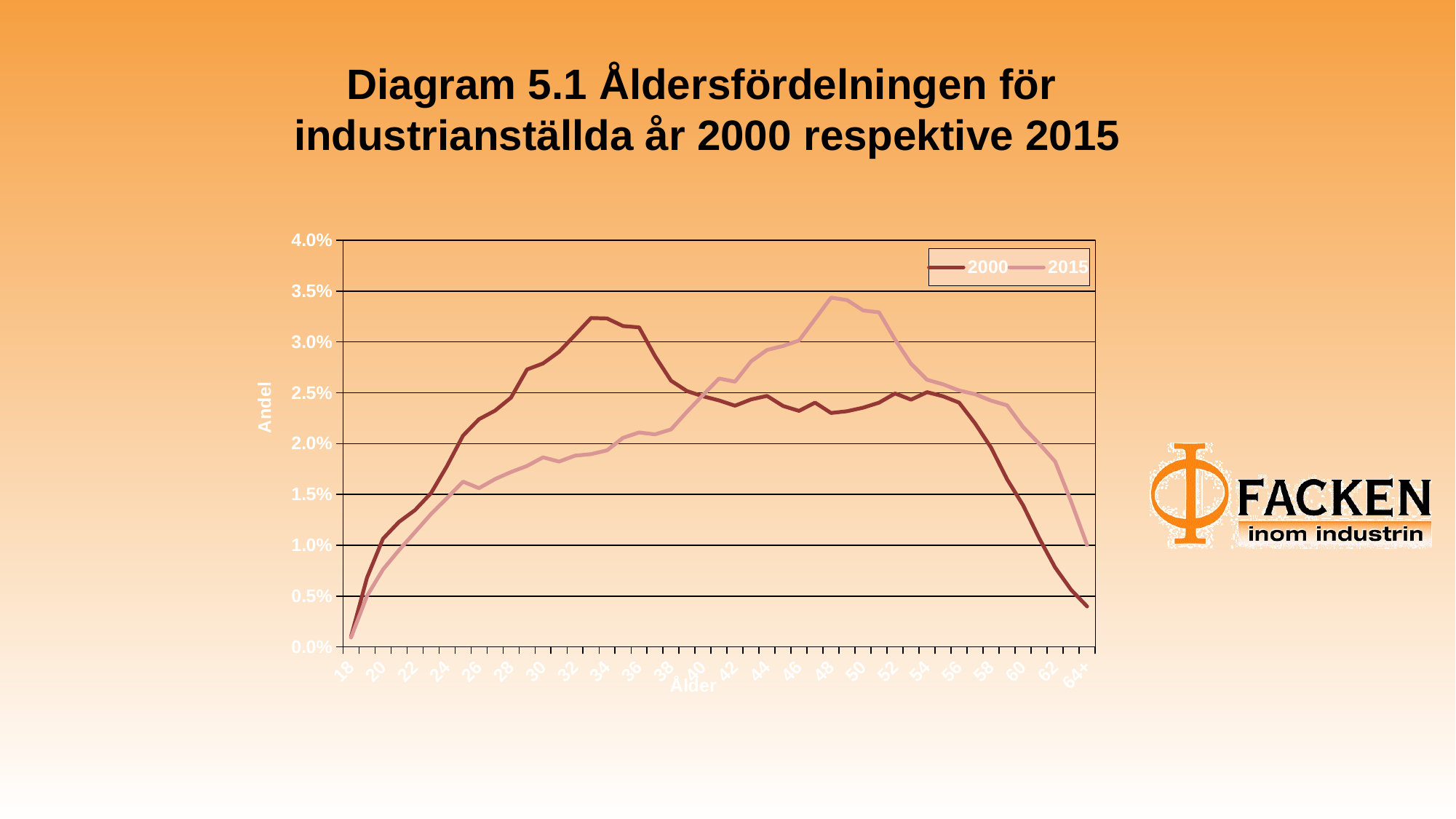
Is the value for the 2000 series at age 34 greater or less than 3.0%? greater Is the value for the 2015 series at age 48 greater or less than 3.0%? greater At age 48, which series has the higher value, 2000 or 2015? 2015 What is the label on the vertical axis? Andel Is the value for the 2015 series at age 34 greater or less than 2.0%? less Which series reaches the higher peak value, 2000 or 2015? 2015 What is the title of the chart? Diagram 5.1 Åldersfördelningen för industrianställda år 2000 respektive 2015 Does the 2015 series rise or fall between age 50 and 64+? fall At age 34, which series has the higher value, 2000 or 2015? 2000 What kind of chart is shown on the slide? line chart How many series does the legend list? 2